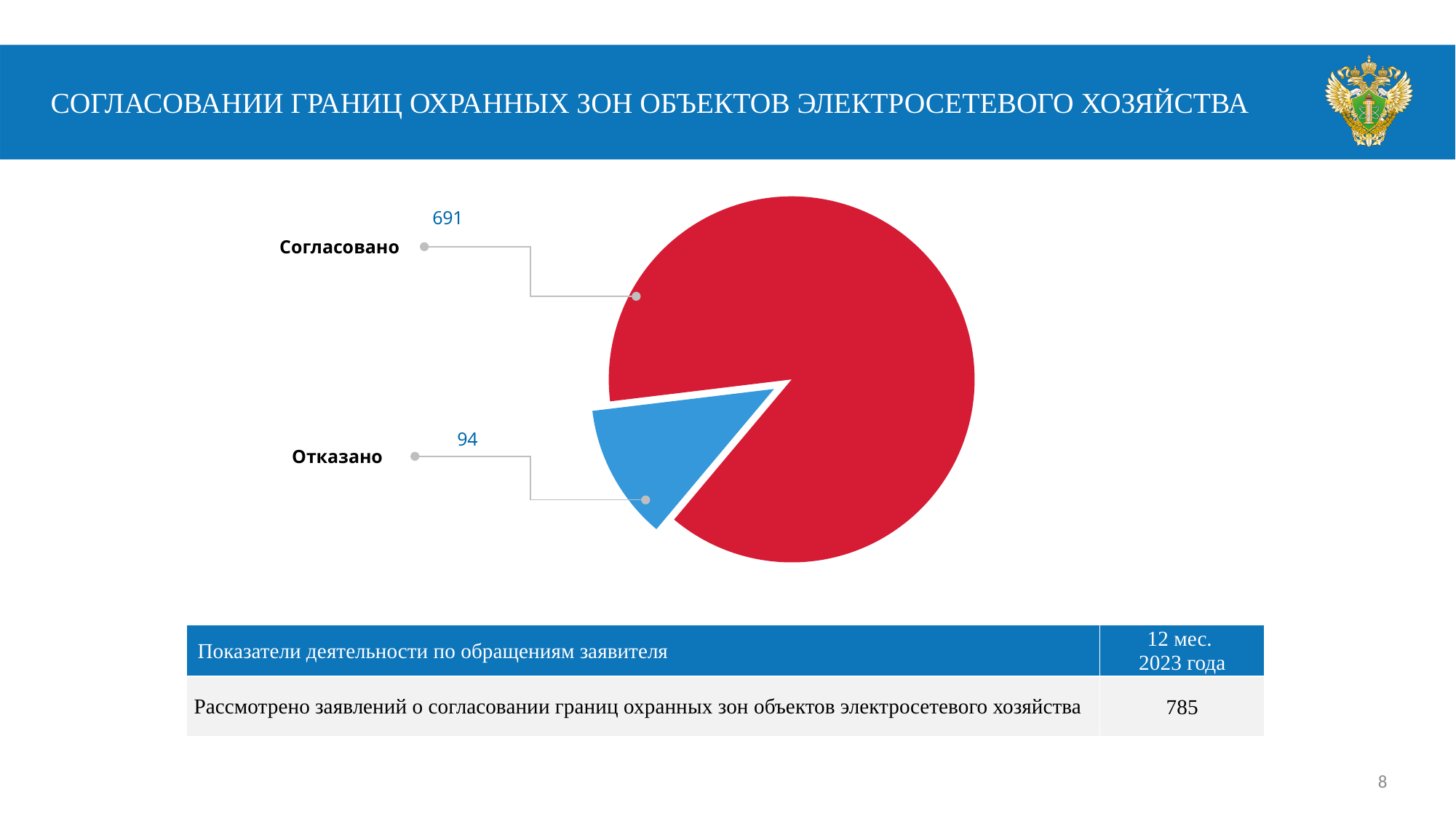
How many slices does the pie chart have? 2 What kind of chart is shown on the slide? Pie chart Which category has the smallest slice in the pie chart? Отказано Which category has the largest slice in the pie chart? Согласовано Which is larger, the value for Согласовано or the value for Отказано? Согласовано What share of the pie does the Отказано slice represent, to the nearest percent? 12% What is the value for Согласовано in the pie chart? 691 What colour is the Отказано slice in the pie chart? Blue What is the value for Отказано in the pie chart? 94 What is the total of the two slices in the pie chart? 785 What is the difference between the values for Согласовано and Отказано? 597 What share of the pie does the Согласовано slice represent, to the nearest percent? 88%